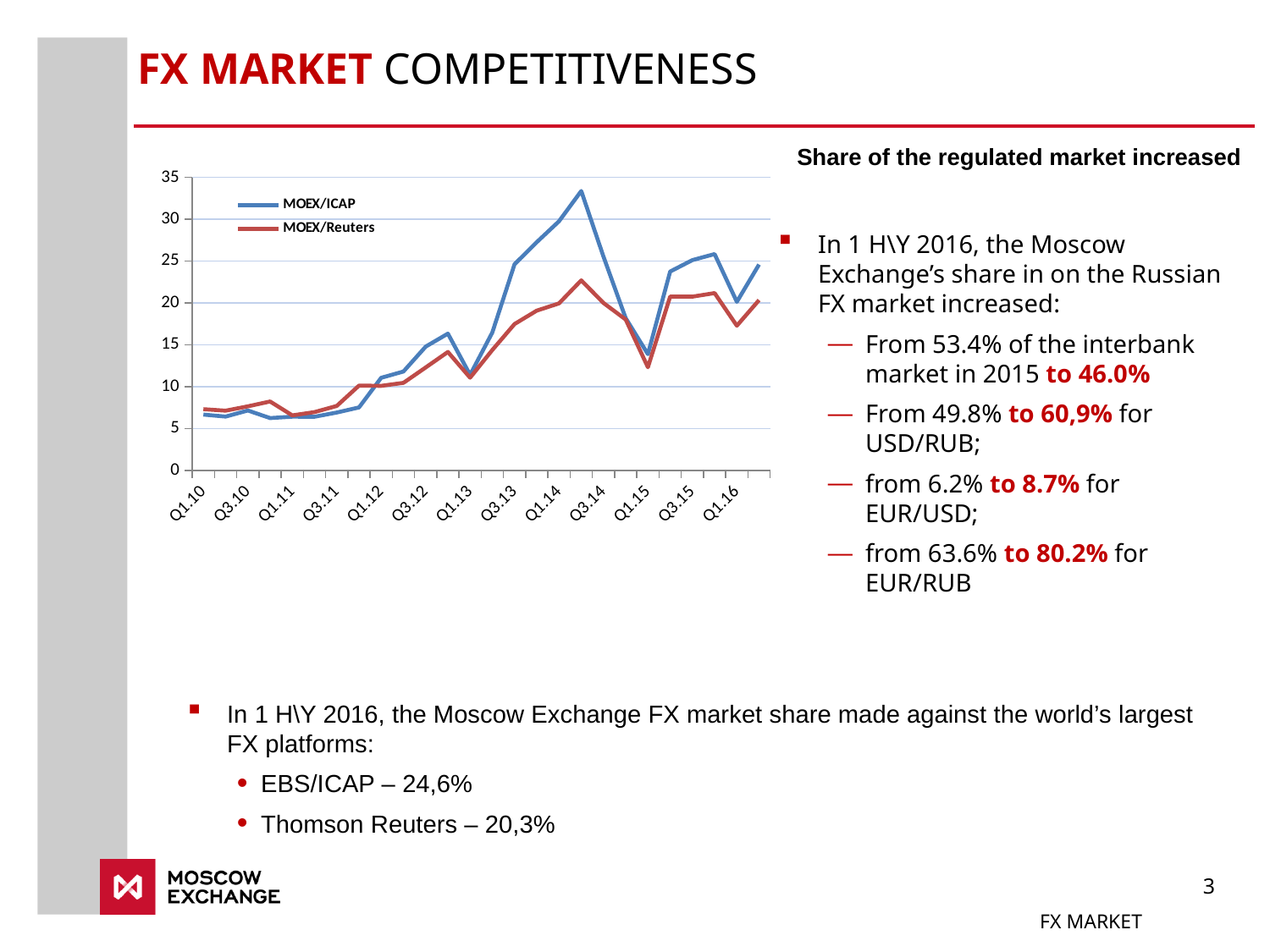
What kind of chart is shown on the slide? Line chart Is the MOEX/ICAP value at Q1.16 greater or less than 15? greater Overall, do the values of the MOEX/ICAP line rise or fall from Q1.10 to Q1.16? Rise How many quarter labels are shown on the x axis of the chart? 13 At Q3.14, which series has the larger value, MOEX/ICAP or MOEX/Reuters? MOEX/ICAP How many series does the chart legend list? 2 Is the peak value of the MOEX/Reuters line greater or less than 25? less Is the peak value of the MOEX/ICAP line greater or less than 30? greater Which series reaches the higher peak value on the chart, MOEX/ICAP or MOEX/Reuters? MOEX/ICAP Which colour is used for the MOEX/Reuters line? Red What are the two series named in the chart legend? MOEX/ICAP and MOEX/Reuters